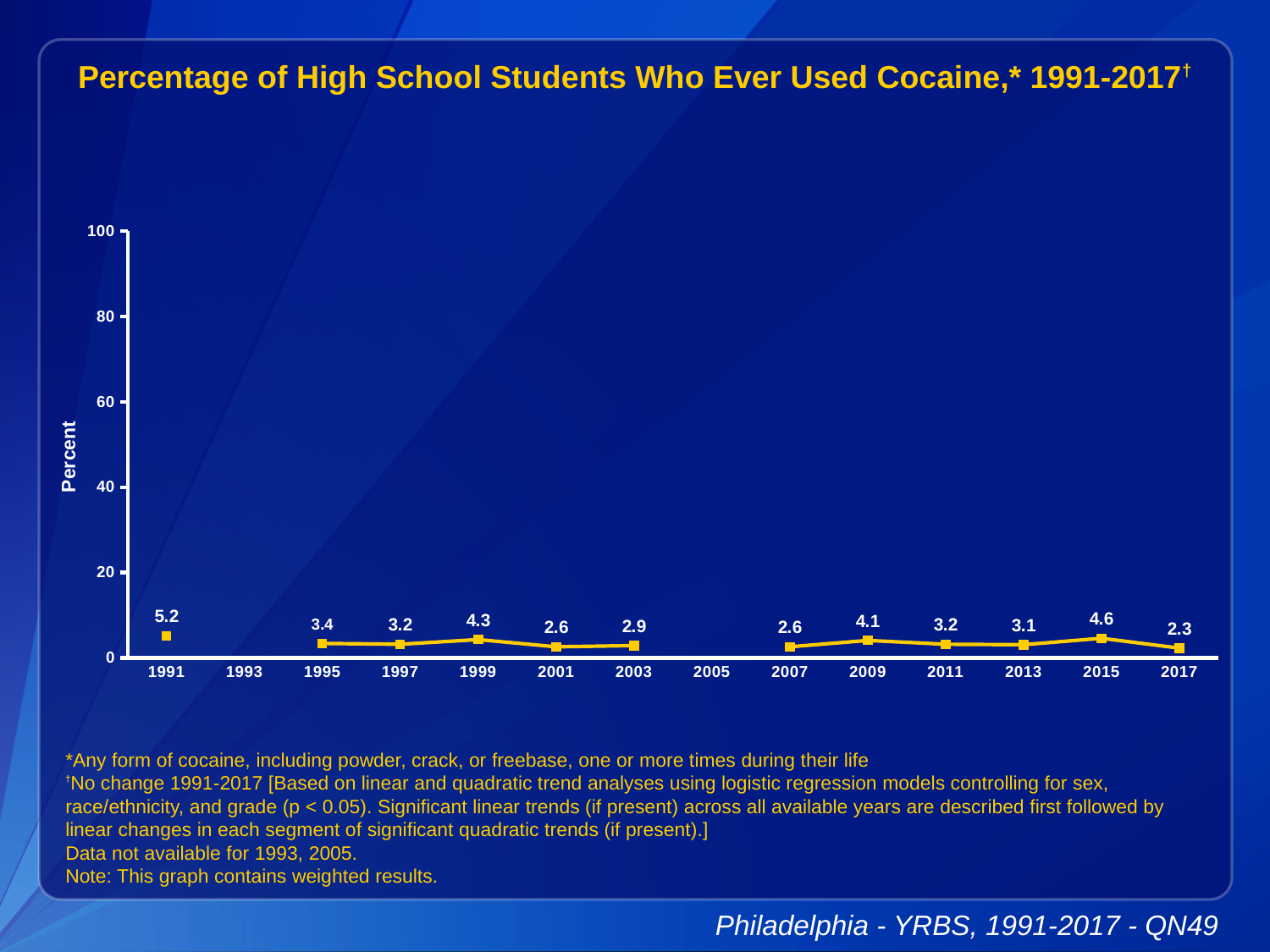
Which year has the highest percentage of students who ever used cocaine? 1991 What is the value plotted for 2009? 4.1 What is the label on the vertical axis of the chart? Percent Which year has the larger value, 1999 or 2015? 2015 What is the difference between the 1991 value and the 2017 value? 2.9 Overall, does the percentage rise or fall from 1991 to 2017? fall What percentage of high school students had ever used cocaine in 1991? 5.2 How many years have a data point plotted on the chart? 12 What is the value plotted for 2017? 2.3 What kind of chart is shown on the slide? line chart Which year has the lowest percentage of students who ever used cocaine? 2017 Is the value for 1991 greater or less than 20? less